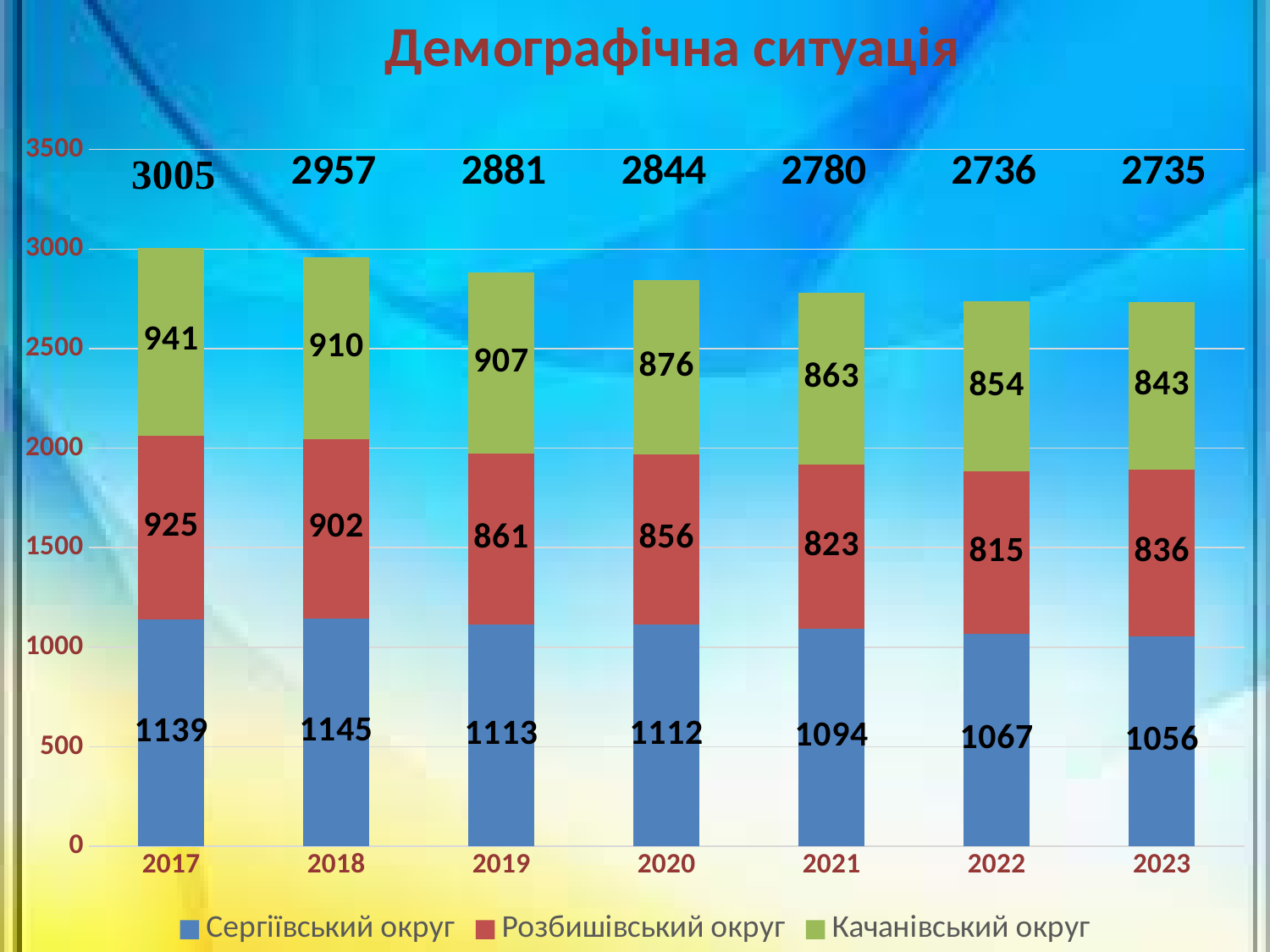
How many years are shown on the x axis? 7 What is the value for Сергіївський округ in 2017? 1139 Do the total values rise or fall from 2017 to 2023? Fall What is the difference between the Сергіївський округ values for 2018 and 2023? 89 What is the total of the stacked bar for 2019? 2881 What kind of chart is shown on the slide? Stacked bar chart What is the value for Розбишівський округ in 2020? 856 Which year has the lowest value for Сергіївський округ? 2023 Which is larger in 2021: Розбишівський округ or Качанівський округ? Качанівський округ How many series does the legend list? 3 Which year has the highest total? 2017 What is the value for Качанівський округ in 2023? 843